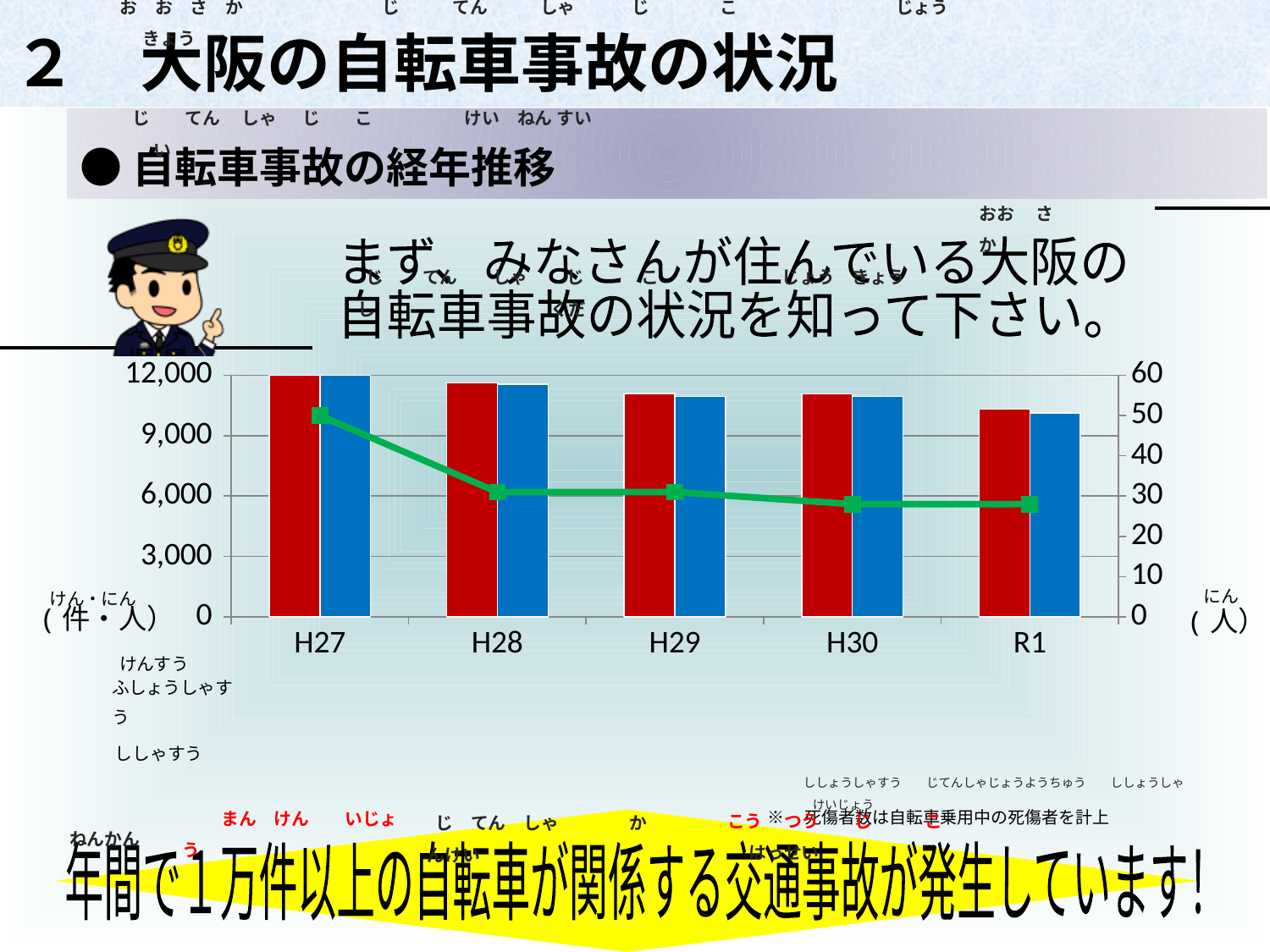
Is the red bar for R1 greater or less than 9,000? greater Which category has the lowest red bar? R1 Which category has the highest point on the green line? H27 Do the values of the green line rise or fall from H27 to R1? fall Which is larger, the red bar for H27 or the red bar for R1? H27 What kind of chart is shown on the slide? bar chart with a line What is the highest tick value shown on the right-hand axis? 60 How many categories are shown on the x axis of the chart? 5 Is the green line value for R1 greater or less than 40? less Is the green line value for H27 greater or less than 40? greater Which category has the highest red bar? H27 Do the red bars rise or fall from H27 to R1? fall